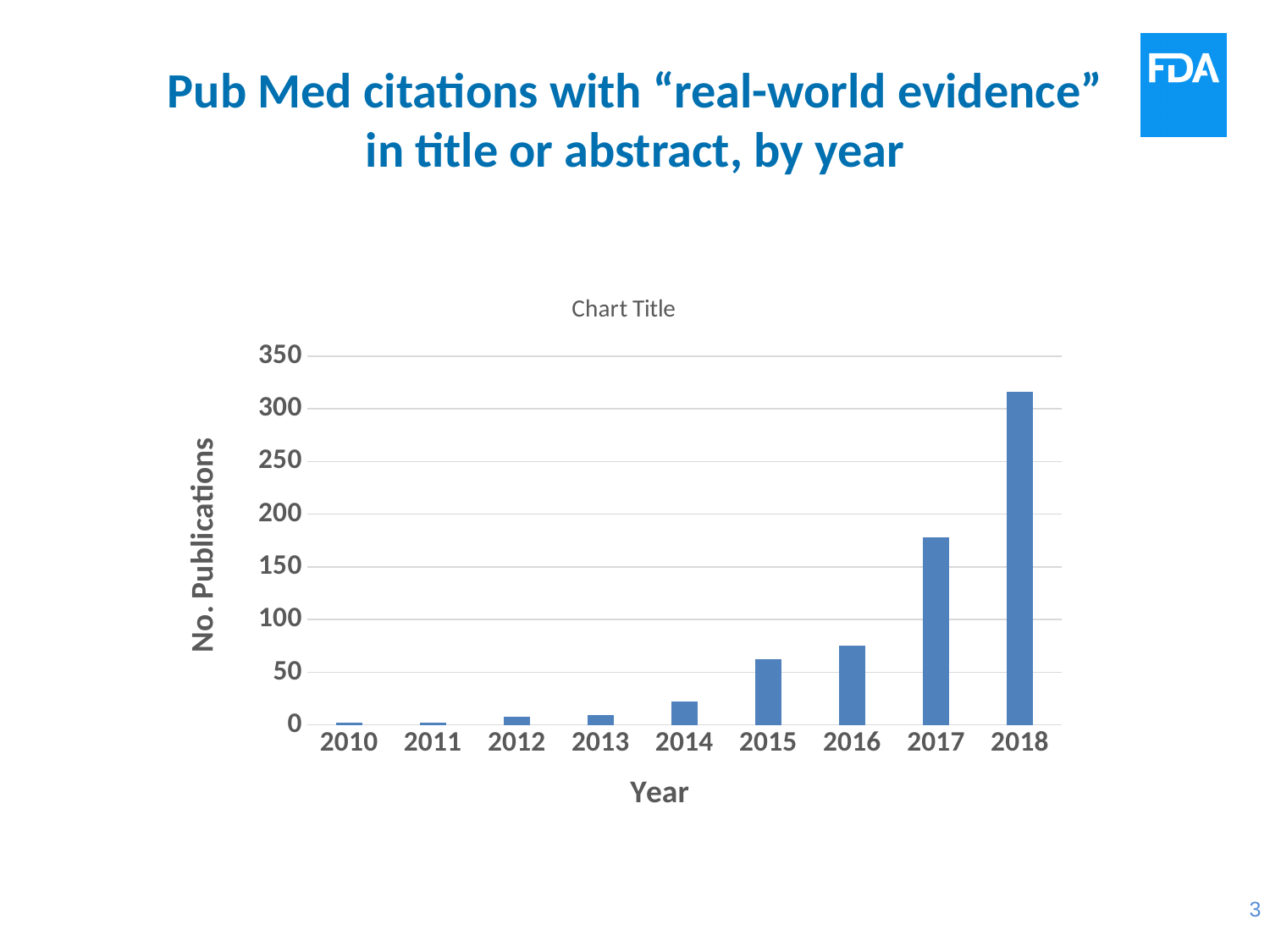
Is the value for 2018 greater or less than 300? greater What kind of chart is shown on the slide? bar chart Is the value for 2015 greater or less than 50? greater Which is larger, the value for 2016 or the value for 2017? 2017 Is the value for 2017 greater or less than 200? less Which year has the highest number of publications? 2018 Do the values generally rise or fall from 2010 to 2018? rise What is the label on the y axis? No. Publications How many years are plotted on the x axis? 9